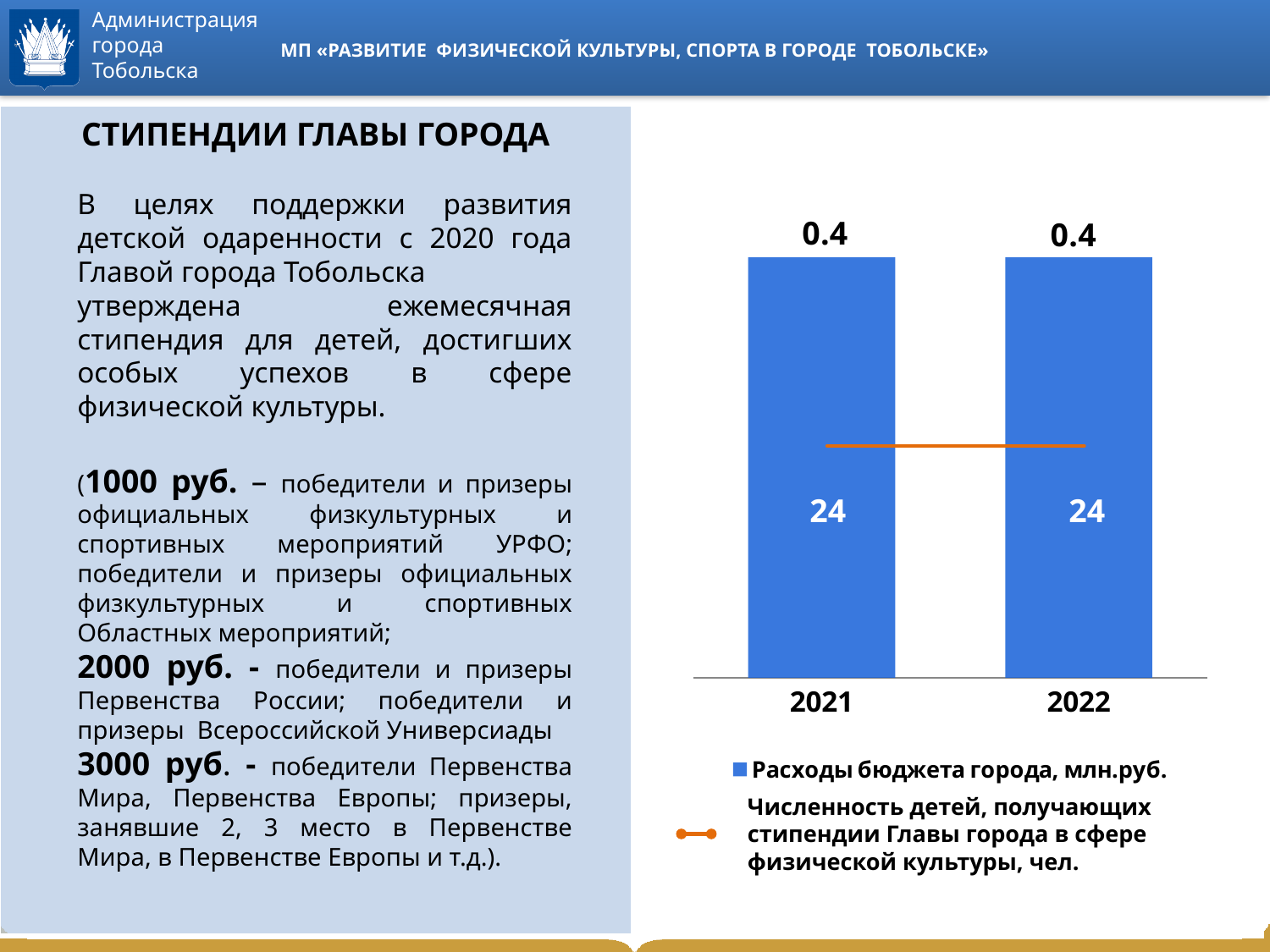
How many series does the chart legend list? 2 What is the difference in the number of children receiving scholarships between 2021 and 2022? 0 How many children received the Head of City scholarship in the field of physical culture in 2021, according to the chart? 24 What is the value of 'Расходы бюджета города, млн.руб.' for 2022? 0.4 Which series in the legend is shown as an orange line? Численность детей, получающих стипендии Главы города в сфере физической культуры, чел. How many children received the Head of City scholarship in the field of physical culture in 2022, according to the chart? 24 What kind of chart is used to show 'Расходы бюджета города, млн.руб.'? bar chart What is the value of 'Расходы бюджета города, млн.руб.' for 2021? 0.4 Does the value of 'Расходы бюджета города, млн.руб.' rise, fall or stay the same from 2021 to 2022? stays the same What is the difference between the 2022 and 2021 values of 'Расходы бюджета города, млн.руб.'? 0 How many years (categories) are shown on the x axis of the chart? 2 What colour are the bars representing 'Расходы бюджета города, млн.руб.'? blue